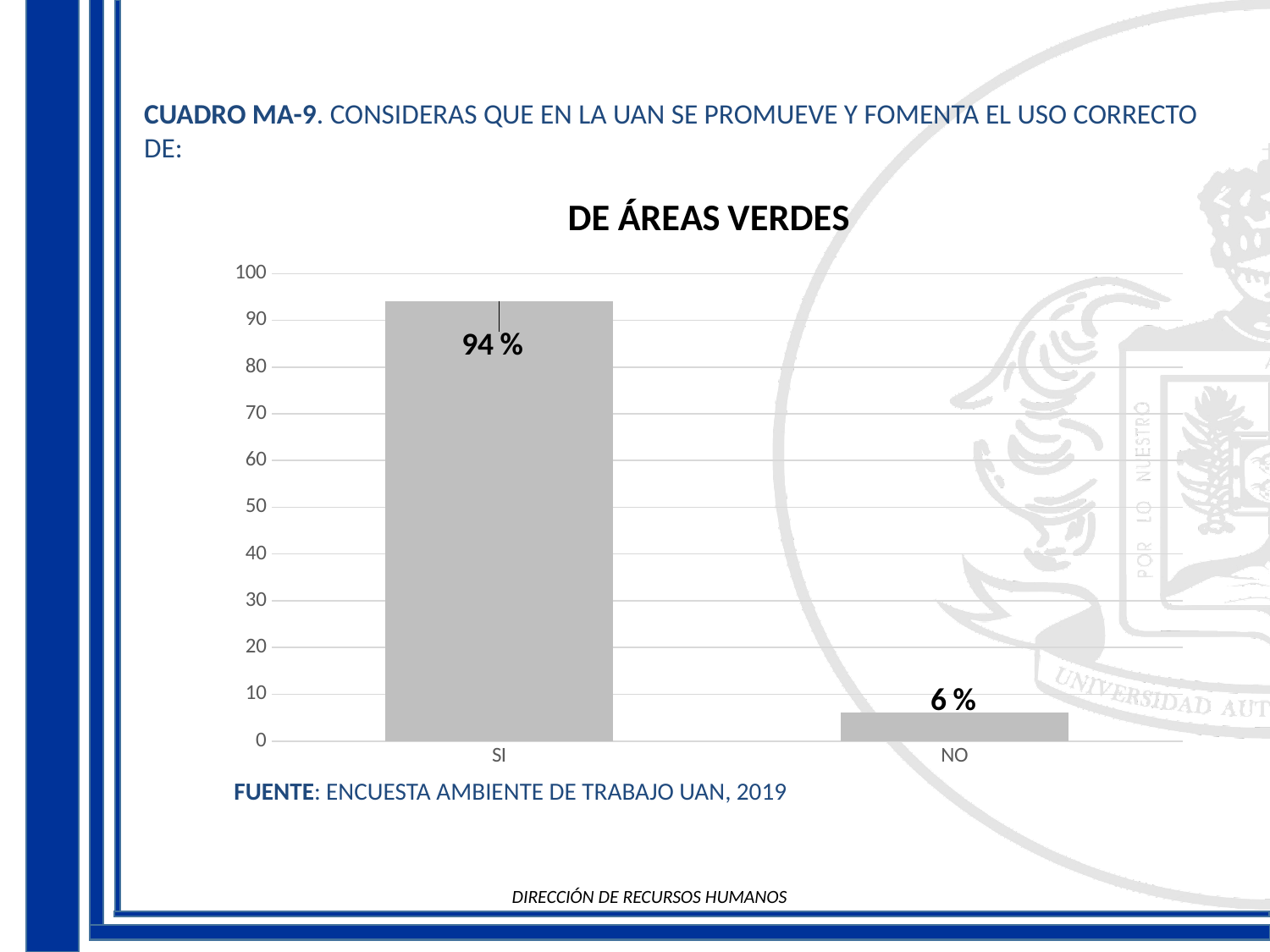
What is the value for NO? 6 % Is the value for NO greater or less than 10? less What is the difference between the values for SI and NO? 88 % Is the value for SI greater or less than 90? greater Which is larger, the value for SI or the value for NO? SI Which category has the highest value? SI What is the maximum value shown on the vertical axis? 100 What is the title of the chart? DE ÁREAS VERDES What is the value for SI? 94 % How many categories are shown on the x axis? 2 What kind of chart is shown? bar chart Which category has the lowest value? NO